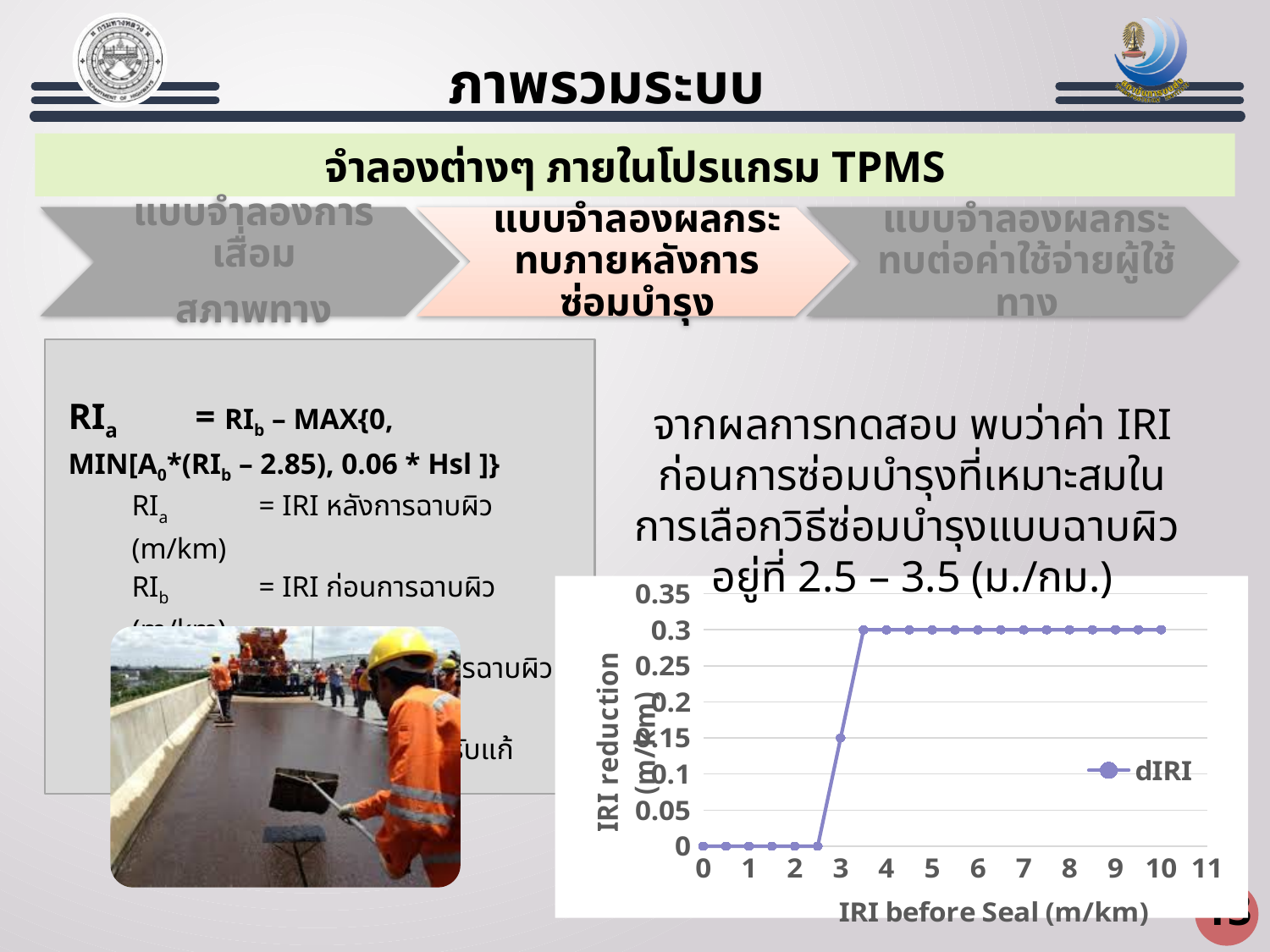
What is the IRI reduction value when IRI before Seal is 3 m/km? 0.15 What is the IRI reduction value when IRI before Seal is 5 m/km? 0.3 What is the name of the series shown in the chart legend? dIRI What is the title of the x axis of the chart? IRI before Seal (m/km) What is the IRI reduction value when IRI before Seal is 1 m/km? 0 How many series does the legend of the chart list? 1 Which has the larger IRI reduction value: IRI before Seal of 2 m/km or 4 m/km? 4 m/km What is the highest IRI reduction value reached by the dIRI series? 0.3 What is the lowest IRI reduction value in the dIRI series? 0 Is the IRI reduction value at IRI before Seal of 8 m/km greater or less than 0.2? greater What kind of chart is shown at the bottom right of the slide? line chart Does the IRI reduction value rise or fall as IRI before Seal increases from 0 to 10? rise